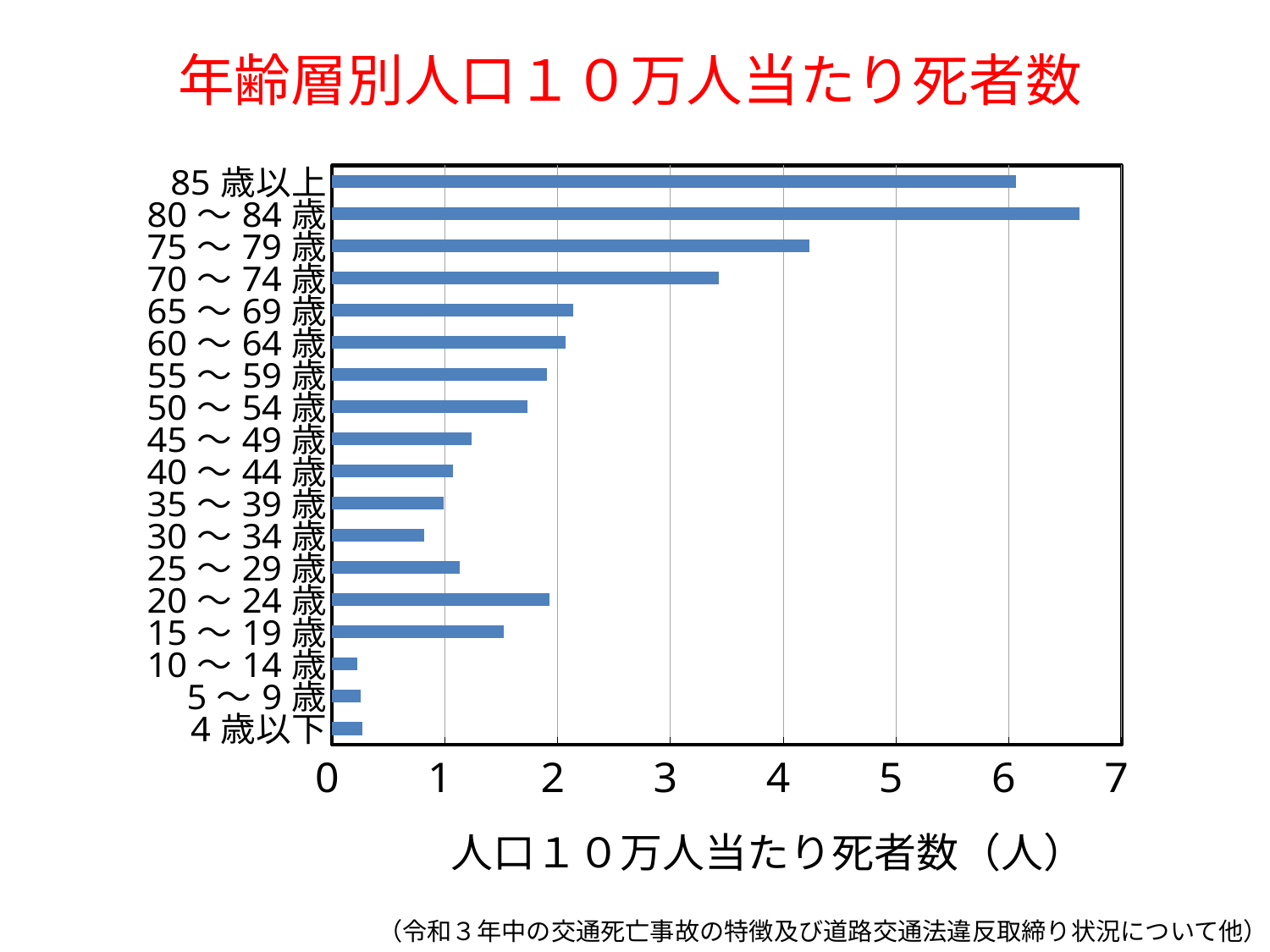
Is the value for 75～79歳 greater or less than 4? greater Is the value for 30～34歳 greater or less than 1? less Which age group has the highest number of deaths per 100,000 population? 80～84歳 What is the label of the horizontal axis? 人口１０万人当たり死者数（人） What is the title of the chart? 年齢層別人口１０万人当たり死者数 Is the value for 70～74歳 greater or less than 3? greater Which is larger, the value for 80～84歳 or the value for 85歳以上? 80～84歳 What kind of chart is shown on the slide? bar chart How many age-group categories are plotted in the chart? 18 Which is larger, the value for 20～24歳 or the value for 15～19歳? 20～24歳